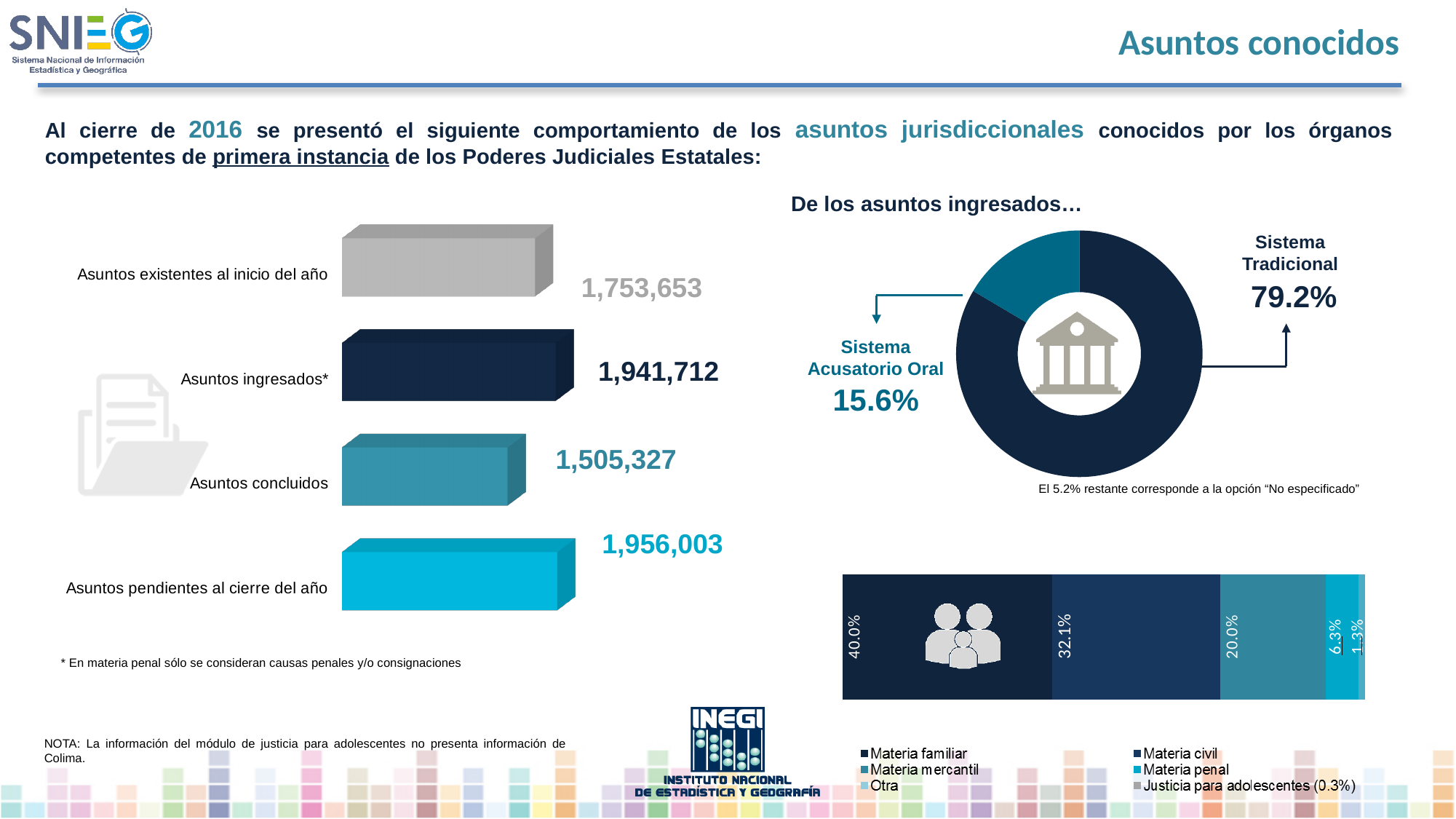
In the bar chart on the left, how many categories are shown? 4 In the bar chart on the left, which category has the lowest value? Asuntos concluidos In the bar chart on the left, what is the value for Asuntos existentes al inicio del año? 1,753,653 In the bar chart on the left, what is the difference between Asuntos ingresados* and Asuntos concluidos? 436,385 In the stacked bar chart at the bottom right, how many series does the legend list? 6 In the donut chart under 'De los asuntos ingresados…', what share corresponds to Sistema Tradicional? 79.2% In the bar chart on the left, which category has the highest value? Asuntos pendientes al cierre del año In the bar chart on the left, what is the value for Asuntos ingresados*? 1,941,712 In the bar chart on the left, what is the value for Asuntos concluidos? 1,505,327 In the stacked bar chart at the bottom right, what is the value for Materia civil? 32.1% What kind of chart is the chart on the left showing Asuntos existentes, ingresados, concluidos and pendientes? Bar chart In the donut chart under 'De los asuntos ingresados…', what share corresponds to Sistema Acusatorio Oral? 15.6%